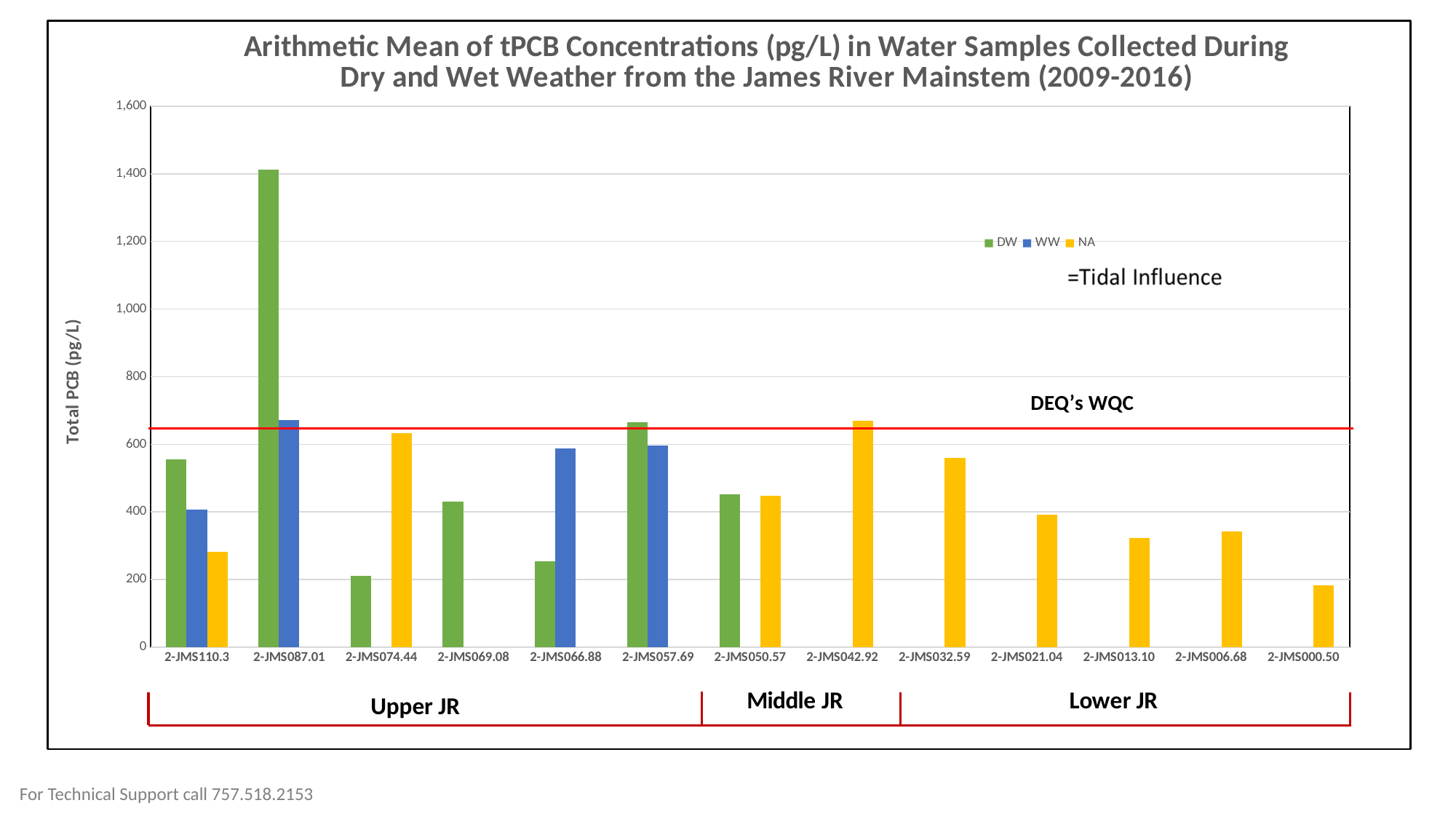
Is the NA value for 2-JMS042.92 greater or less than 600? greater How many sampling stations are shown along the x axis? 13 At 2-JMS110.3, which is larger, the DW value or the WW value? DW Which station has the highest bar on the chart? 2-JMS087.01 Is the DW value for 2-JMS074.44 greater or less than 400? less What kind of chart is shown on the slide? bar chart How many series does the legend list? 3 At 2-JMS066.88, which is larger, the DW value or the WW value? WW Is the DW value for 2-JMS087.01 greater or less than 1,200? greater What does the horizontal red line on the chart represent? DEQ's WQC Among the NA (yellow) bars, which station has the lowest value? 2-JMS000.50